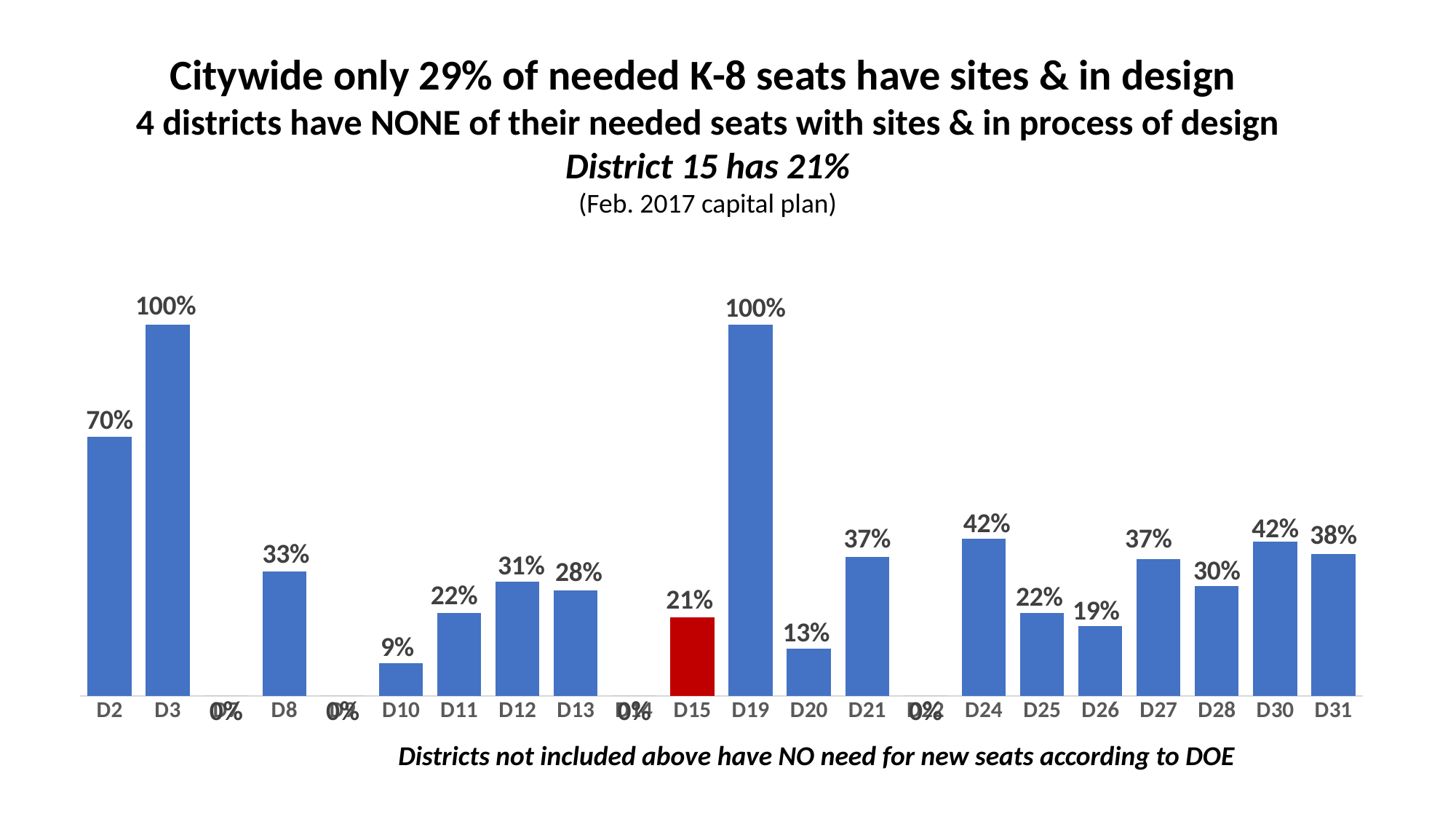
Which districts have the highest value on the chart? D3 and D19 What is the highest value shown on the chart? 100% Which district has the lowest non-zero value on the chart? D10 How many districts on the chart show a value of 0%? 4 What is the value shown for D24? 42% What kind of chart is shown on the slide? Bar chart What is the difference between the values for D2 and D8? 37 percentage points What is the value shown for D15? 21% What is the value shown for D2? 70% What is the value shown for D20? 13% What is the value shown for D31? 38% Which has the larger value, D12 or D13? D12